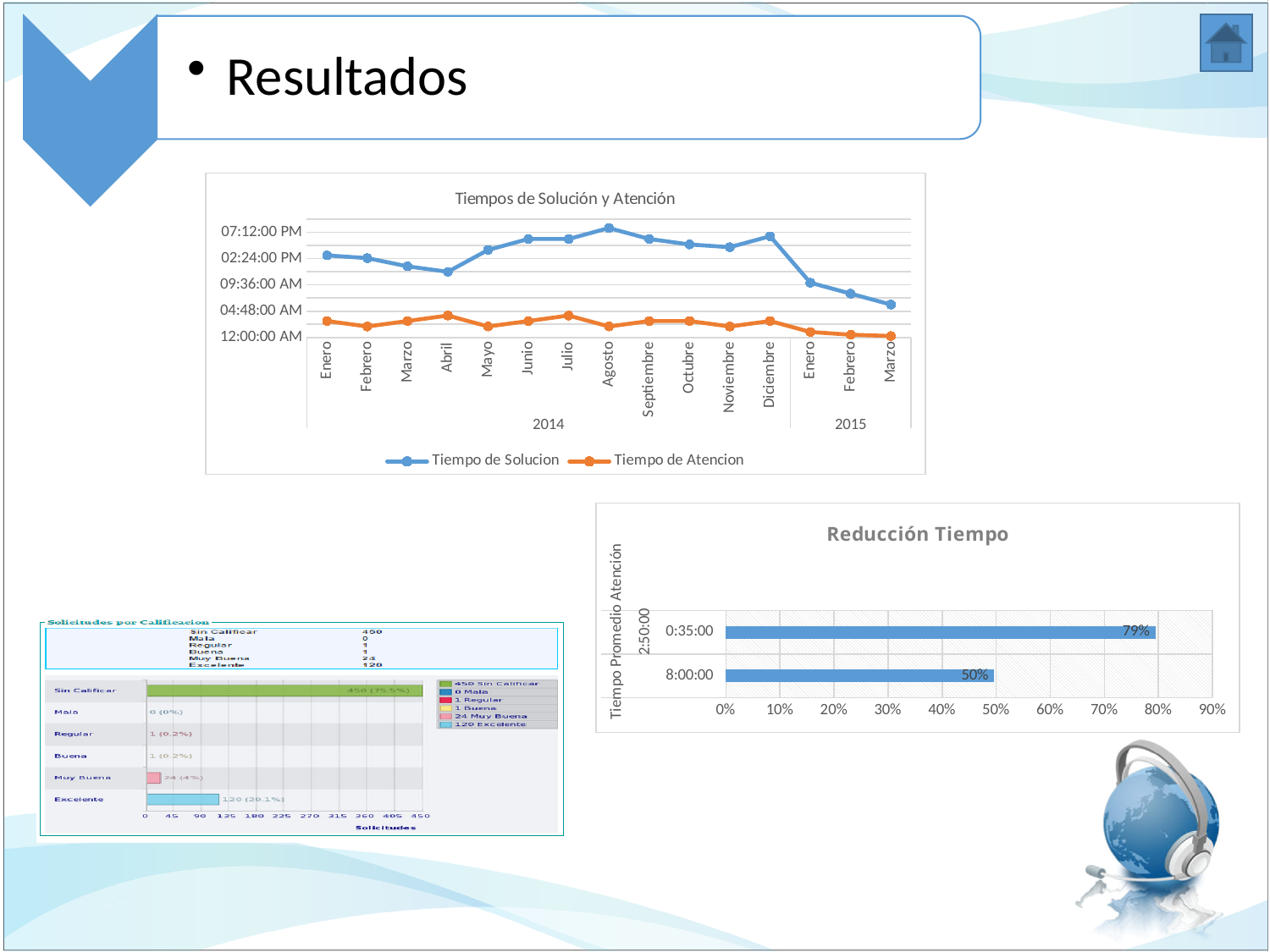
In the 'Reducción Tiempo' chart, what is the value for 0:35:00? 79% What kind of chart is 'Reducción Tiempo'? Bar chart In the 'Solicitudes por Calificación' chart at the bottom left, what is the value for Excelente? 120 (20.1%) In 'Tiempos de Solución y Atención', how many months are plotted along the x axis? 15 What kind of chart is 'Tiempos de Solución y Atención'? Line chart In the 'Reducción Tiempo' chart, what is the value for 8:00:00? 50% How many series does the legend of 'Tiempos de Solución y Atención' list? 2 In the 'Reducción Tiempo' chart, which category has the higher value? 0:35:00 In the 'Reducción Tiempo' chart, what is the difference between the values for 0:35:00 and 8:00:00? 29% In the 'Solicitudes por Calificación' chart at the bottom left, which category has the highest value? Sin Calificar In 'Tiempos de Solución y Atención', in which month does Tiempo de Solucion reach its highest point? Agosto 2014 In 'Tiempos de Solución y Atención', does Tiempo de Solucion rise or fall from Diciembre 2014 to Marzo 2015? Fall